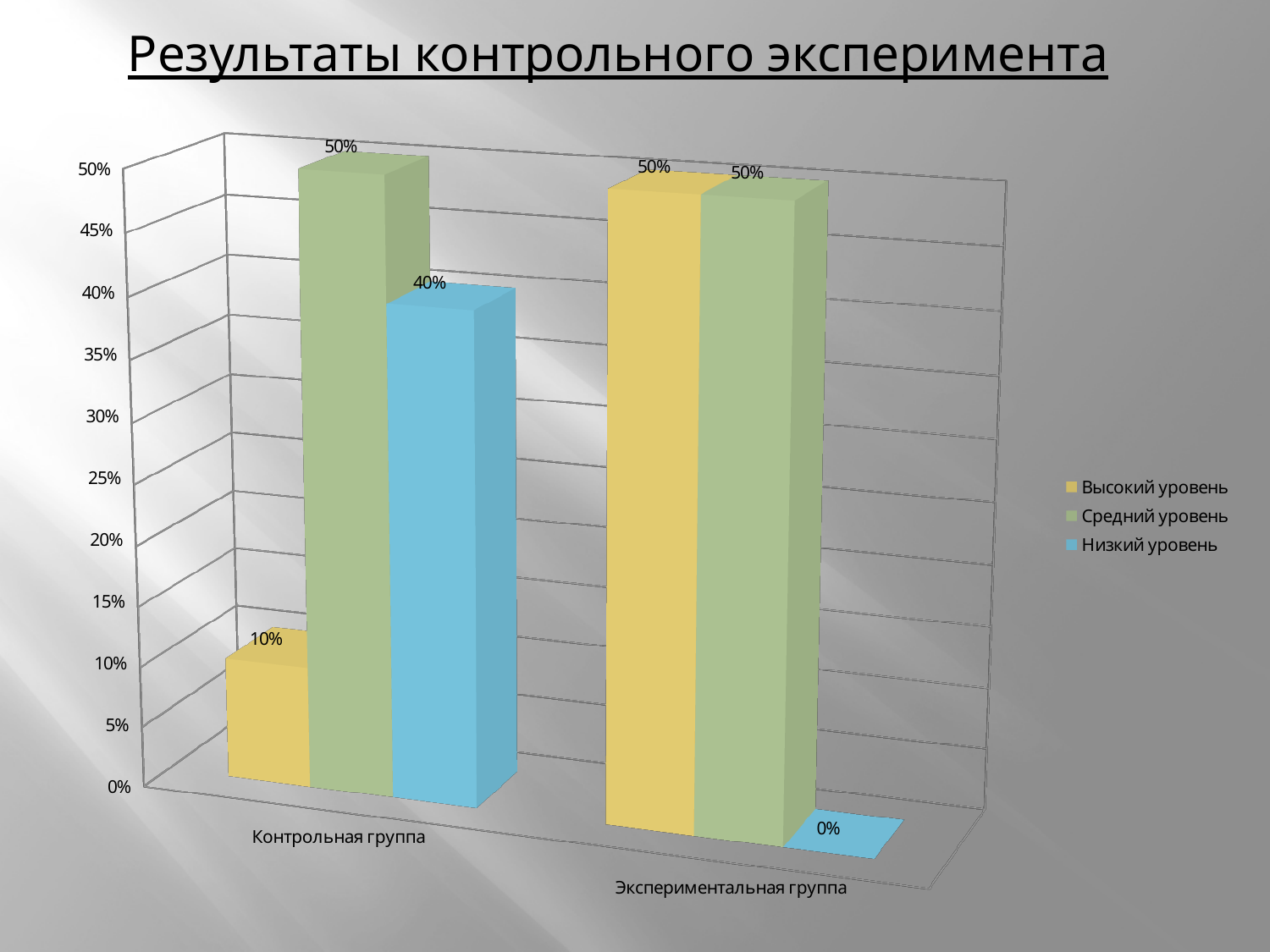
What is the difference between Средний уровень and Высокий уровень in the Контрольная группа? 40% What is the value for Высокий уровень in the Контрольная группа? 10% How many series does the legend list? 3 Which is larger: Низкий уровень in the Контрольная группа or Низкий уровень in the Экспериментальная группа? Контрольная группа What is the value for Высокий уровень in the Экспериментальная группа? 50% What is the difference between Высокий уровень in the Экспериментальная группа and Высокий уровень in the Контрольная группа? 40% What kind of chart is shown on the slide? Bar chart What is the value for Низкий уровень in the Экспериментальная группа? 0% Which level has the highest value in the Контрольная группа? Средний уровень Which level has the lowest value in the Контрольная группа? Высокий уровень How many groups (categories) are shown on the x axis? 2 What is the value for Низкий уровень in the Контрольная группа? 40%